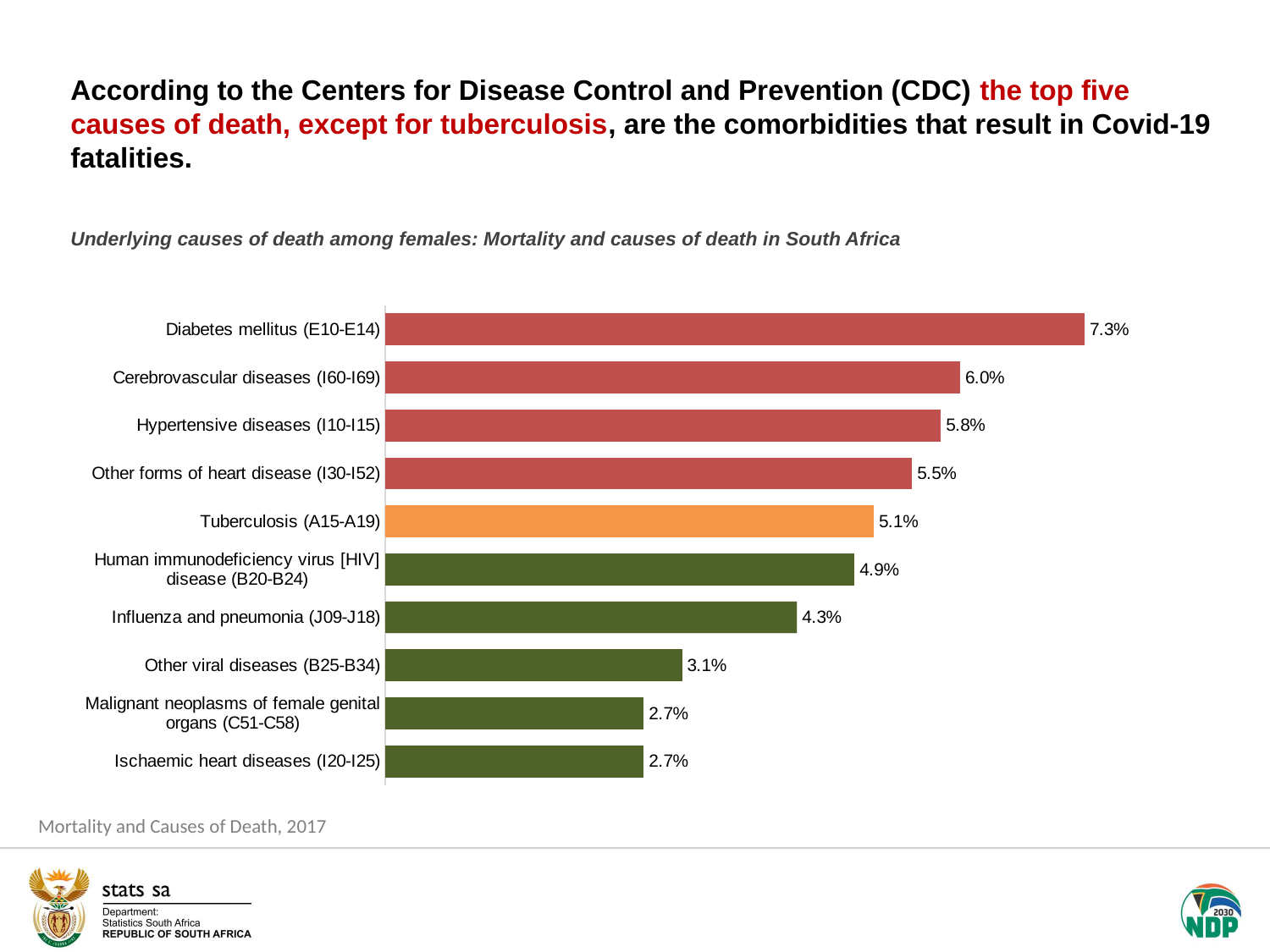
How many causes of death are shown in the chart? 10 Which bar is coloured orange? Tuberculosis (A15-A19) Which is larger, Human immunodeficiency virus [HIV] disease (B20-B24) or Influenza and pneumonia (J09-J18)? Human immunodeficiency virus [HIV] disease (B20-B24) What is the value for Malignant neoplasms of female genital organs (C51-C58)? 2.7% What is the value for Tuberculosis (A15-A19)? 5.1% What is the value for Influenza and pneumonia (J09-J18)? 4.3% What is the difference between Tuberculosis (A15-A19) and Other viral diseases (B25-B34)? 2.0% What is the value for Diabetes mellitus (E10-E14)? 7.3% Which is larger, Hypertensive diseases (I10-I15) or Other forms of heart disease (I30-I52)? Hypertensive diseases (I10-I15) What is the difference between Diabetes mellitus (E10-E14) and Cerebrovascular diseases (I60-I69)? 1.3% Which cause of death has the highest value? Diabetes mellitus (E10-E14) What kind of chart is shown on the slide? Bar chart